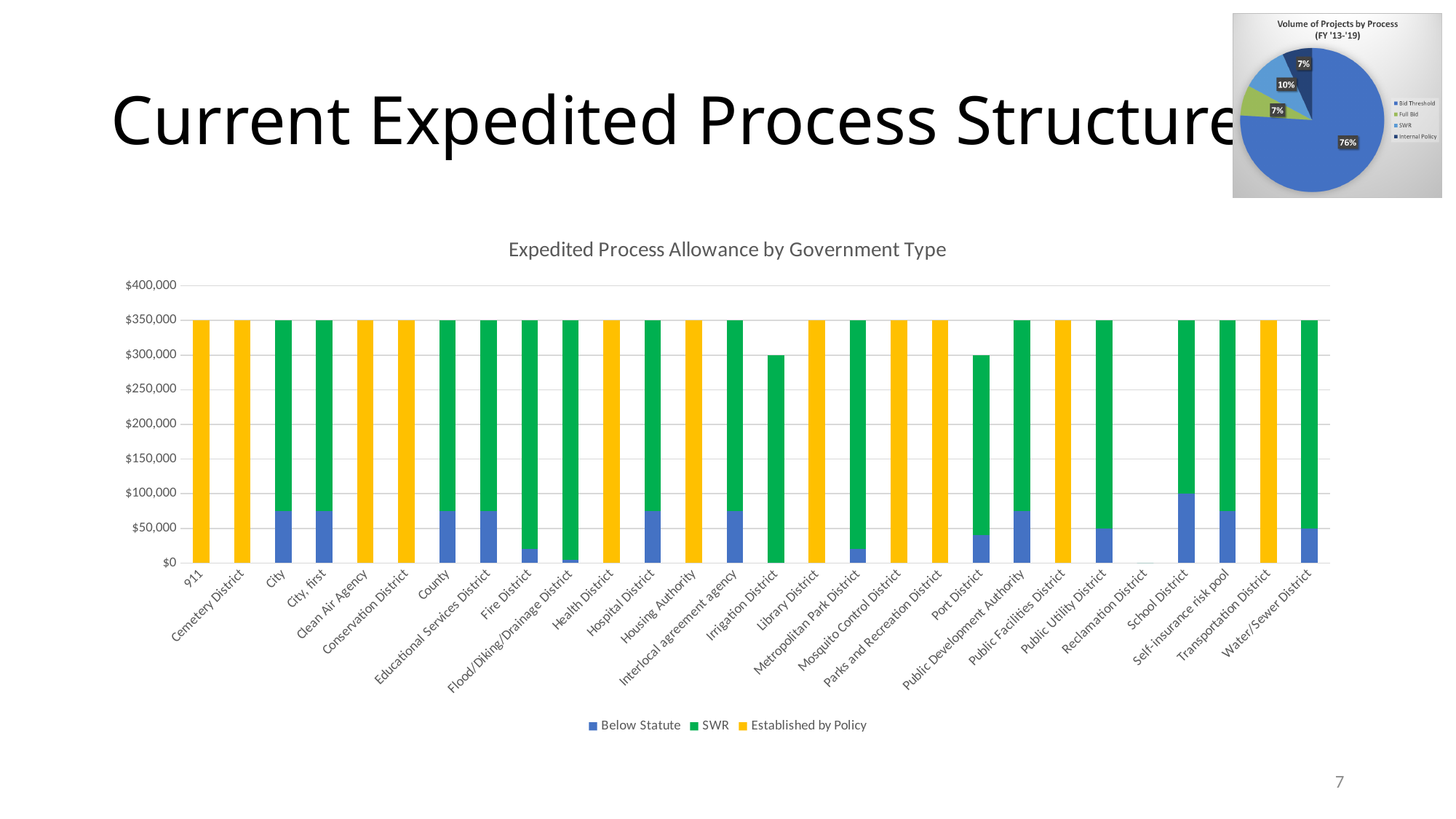
In the chart 'Expedited Process Allowance by Government Type', is the total bar for Port District greater or less than $350,000? less In the chart 'Expedited Process Allowance by Government Type', is the Below Statute value for Fire District greater or less than $50,000? less In the pie chart 'Volume of Projects by Process (FY '13-'19)', what share of projects is SWR? 10% In the chart 'Expedited Process Allowance by Government Type', how many government types are shown on the x axis? 28 In the chart 'Expedited Process Allowance by Government Type', is the Below Statute value for School District greater or less than $50,000? greater In the pie chart 'Volume of Projects by Process (FY '13-'19)', which process has the largest slice? Bid Threshold In the pie chart 'Volume of Projects by Process (FY '13-'19)', how many entries does the legend list? 4 What kind of chart is 'Expedited Process Allowance by Government Type'? Stacked bar chart In the chart 'Expedited Process Allowance by Government Type', how many series does the legend list? 3 In the pie chart 'Volume of Projects by Process (FY '13-'19)', what share of projects is Bid Threshold? 76% In the chart 'Expedited Process Allowance by Government Type', which series is shown in yellow? Established by Policy